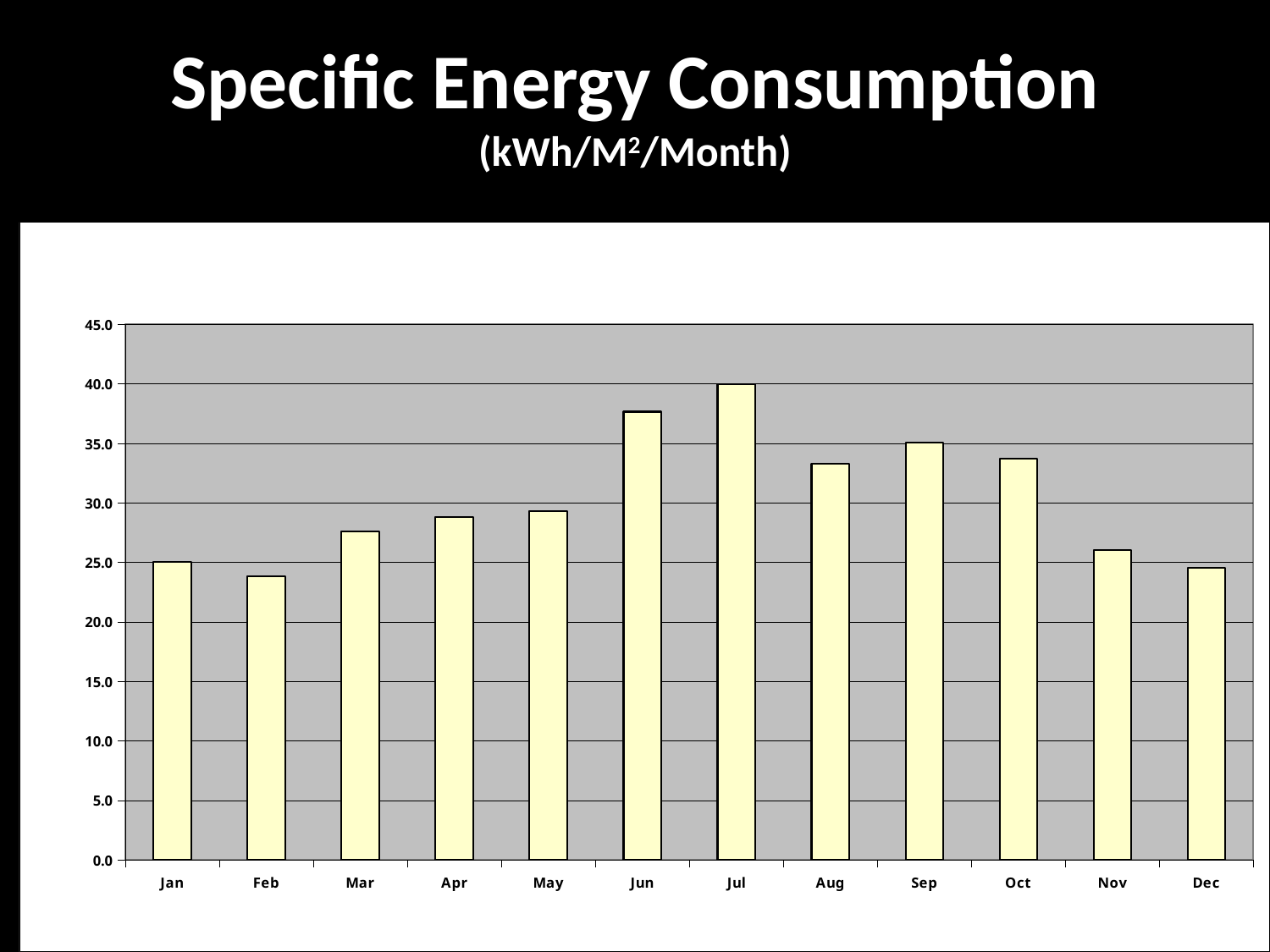
Which month has the highest specific energy consumption? Jul What unit is given in the slide title for specific energy consumption? kWh/M²/Month How many months are plotted on the x axis? 12 Is the value for Aug greater or less than 30.0? greater Is the value for Oct greater or less than 35.0? less Which is larger, the value for Mar or the value for Feb? Mar Is the value for Jun greater or less than 35.0? greater Do the values rise or fall from Jan to Jul? rise Which is larger, the value for Jun or the value for Aug? Jun What kind of chart is shown on the slide? bar chart